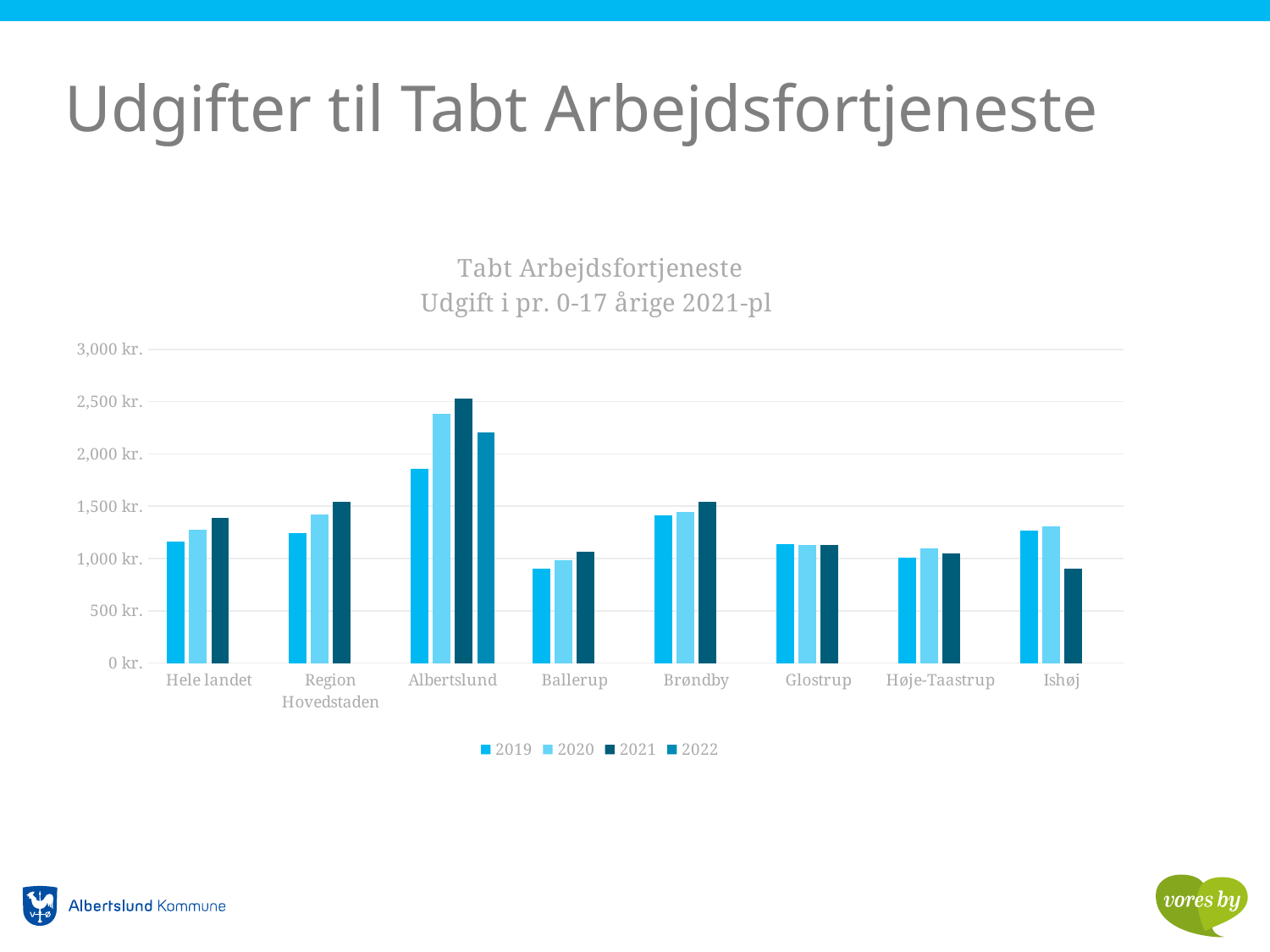
What is the title of the chart? Tabt Arbejdsfortjeneste Udgift i pr. 0-17 årige 2021-pl How many series does the legend list? 4 Is the value for Ballerup in 2019 greater or less than 1,000 kr.? less Is the value for Glostrup in 2021 greater or less than 1,500 kr.? less What kind of chart is shown on the slide? bar chart Do the values for Region Hovedstaden rise or fall from 2019 to 2021? rise Is the value for Albertslund in 2020 greater or less than 2,000 kr.? greater Which category has the highest bars in the chart? Albertslund Which is larger, the 2021 value for Albertslund or the 2021 value for Brøndby? Albertslund How many categories are shown on the x axis of the chart? 8 Which category is the only one with a bar for 2022? Albertslund